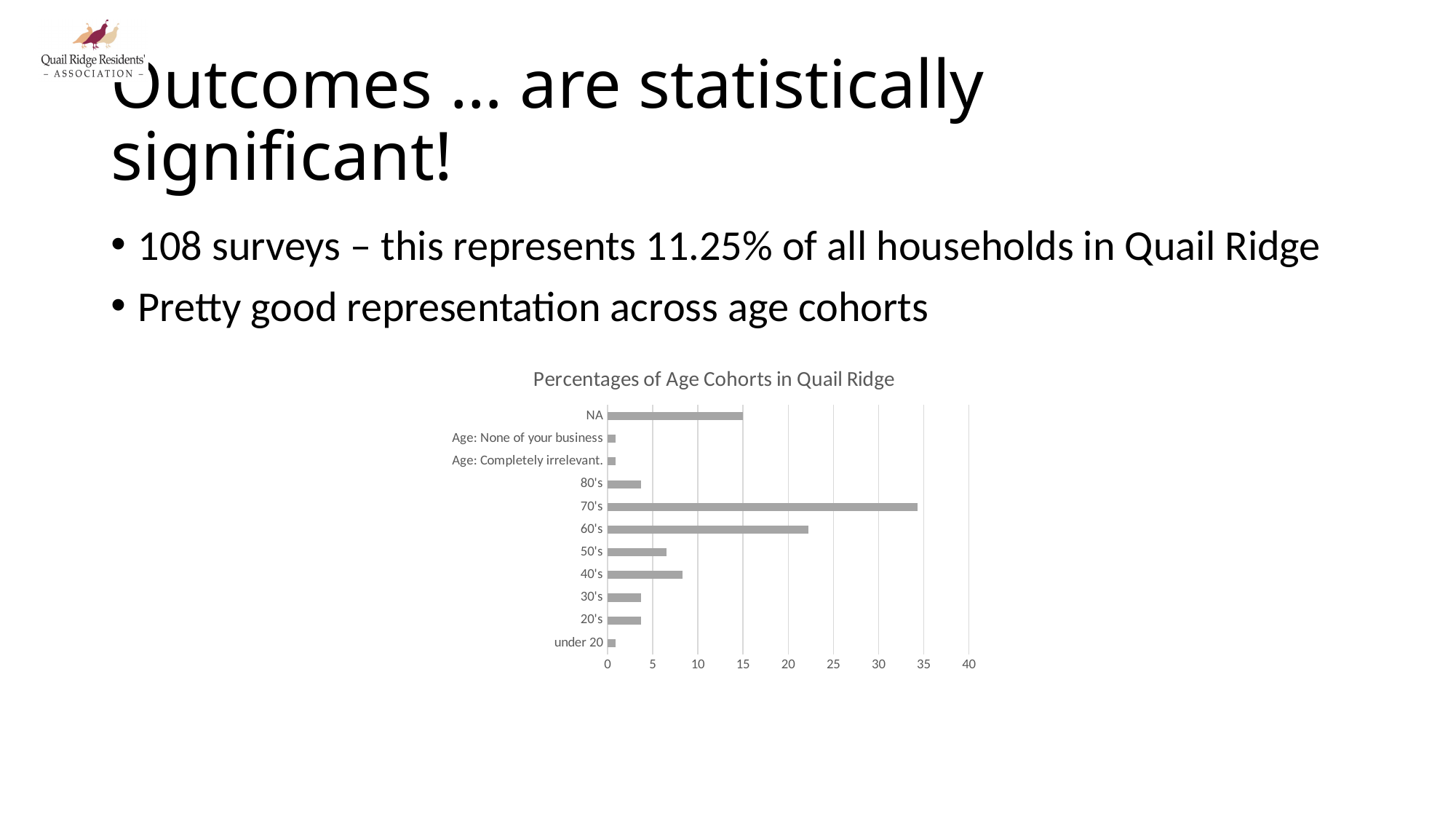
Which is larger, the value for 60's or the value for 70's? 70's How many categories are plotted in the chart? 11 Is the value for NA greater or less than 10? greater What is the title of the chart? Percentages of Age Cohorts in Quail Ridge Which is larger, the value for 40's or the value for 50's? 40's Is the value for 40's greater or less than 5? greater Is the value for 60's greater or less than 20? greater What is the highest value shown on the horizontal axis of the chart? 40 Which category has the highest value in the chart? 70's What kind of chart is shown on the slide? bar chart